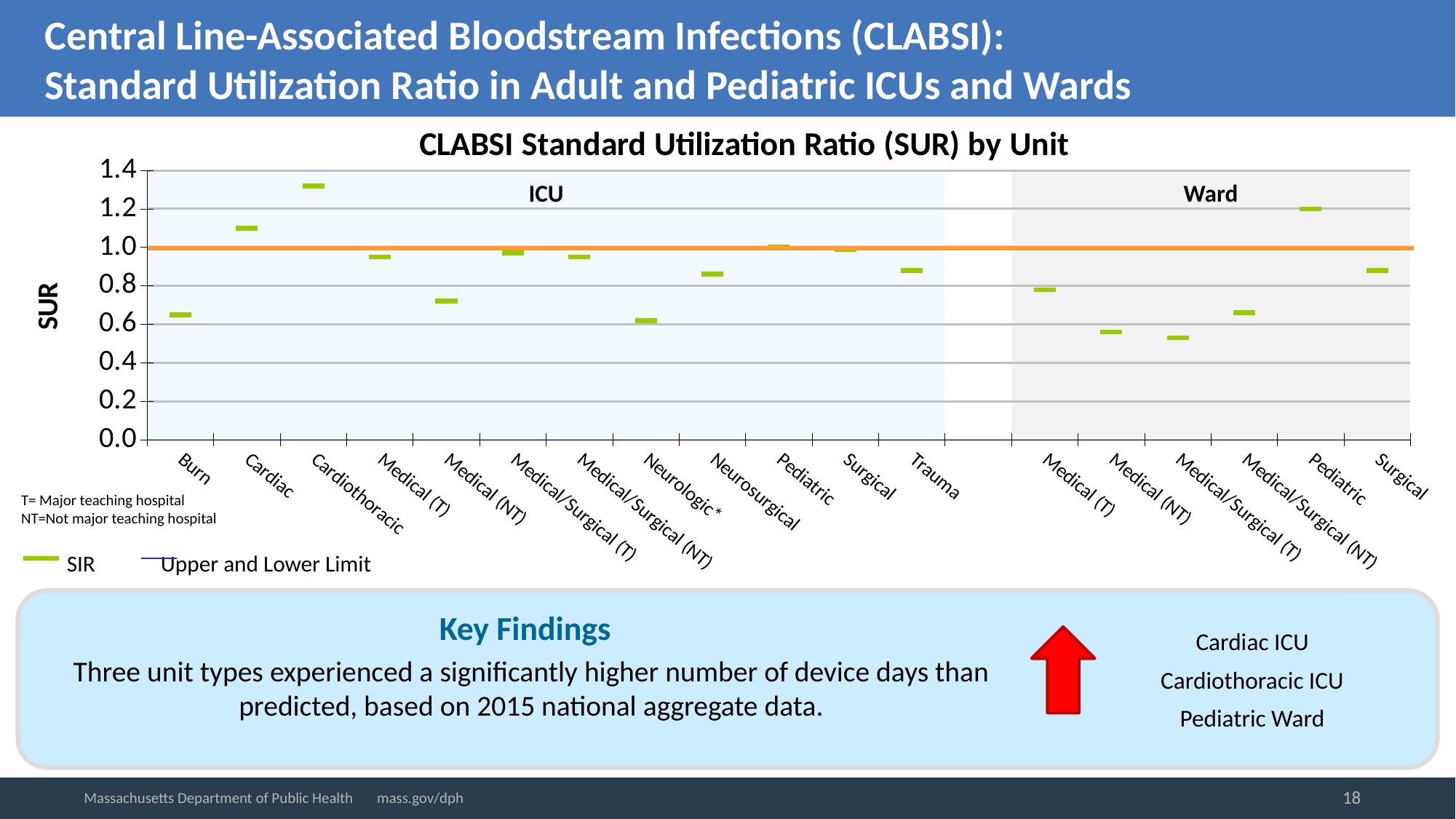
How many unit categories are plotted in the ICU section of the chart? 12 Is the SUR value for the Burn ICU greater or less than 0.8? less How many series does the chart legend list? 2 Is the SUR value for the Medical/Surgical (NT) Ward greater or less than 0.6? greater Is the SUR value for the Cardiothoracic ICU greater or less than 1.2? greater What is the label on the vertical axis of the chart? SUR How many unit categories are plotted in the Ward section of the chart? 6 Which unit has the highest SUR in the chart? Cardiothoracic (ICU) Which has the larger SUR, the Cardiac ICU or the Burn ICU? Cardiac ICU Which has the larger SUR, the Pediatric Ward or the Medical (T) Ward? Pediatric Ward What is the title of the chart? CLABSI Standard Utilization Ratio (SUR) by Unit